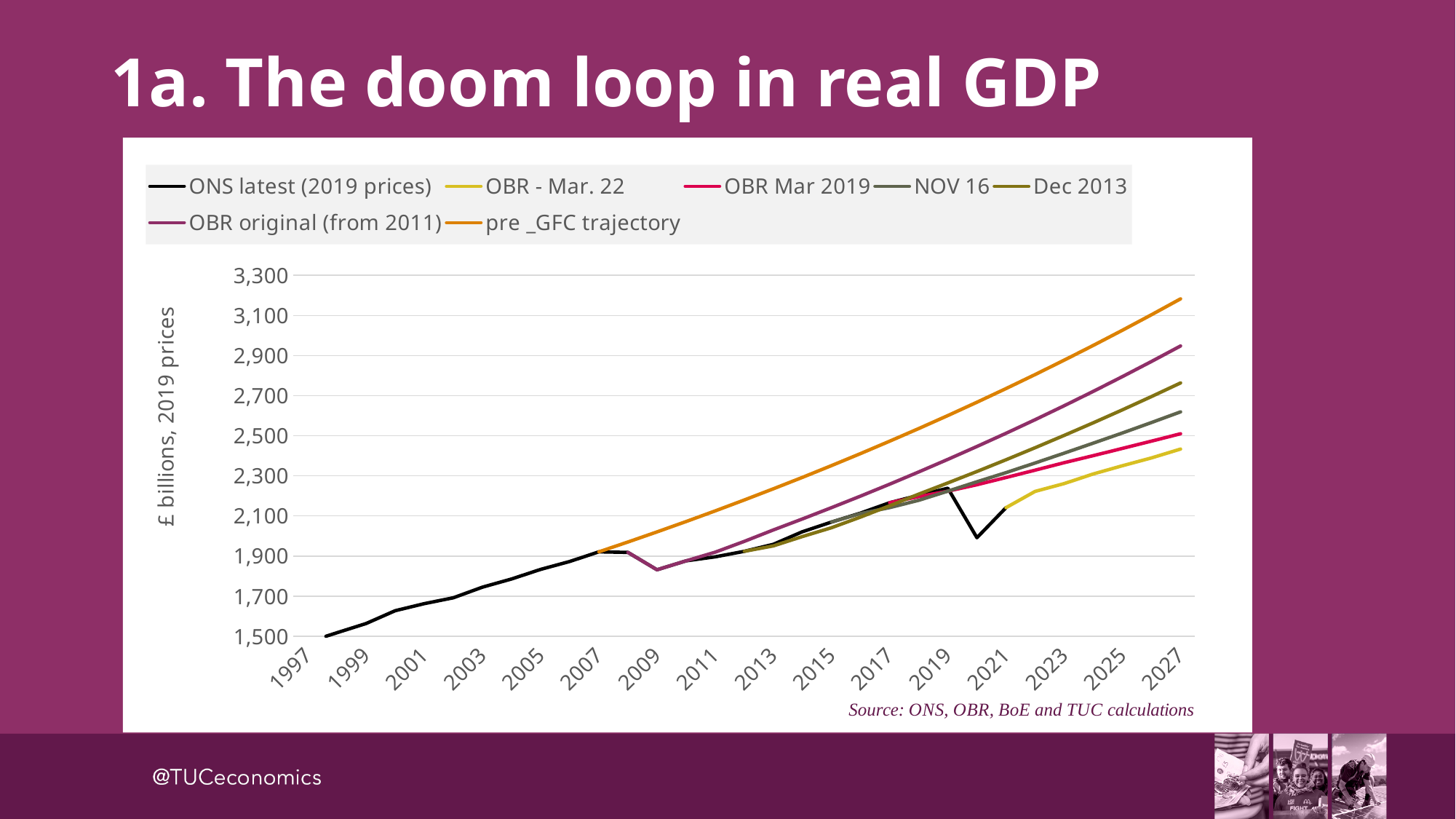
What is the title of the slide containing the chart? 1a. The doom loop in real GDP Does the ONS latest (2019 prices) series rise or fall between 1997 and 2007? rise Is the value for OBR - Mar. 22 in 2027 greater or less than 2,500? less Is the value for ONS latest (2019 prices) in 1997 greater or less than 1,700? less How many year labels are shown on the horizontal axis? 16 In 2027, which is larger: OBR Mar 2019 or OBR - Mar. 22? OBR Mar 2019 Which series has the highest value in 2027? pre _GFC trajectory How many series does the legend list? 7 What is the label on the vertical axis of the chart? £ billions, 2019 prices What kind of chart is shown on the slide? line chart Is the value for the pre _GFC trajectory in 2027 greater or less than 3,100? greater Which series has the lowest value in 2027? OBR - Mar. 22